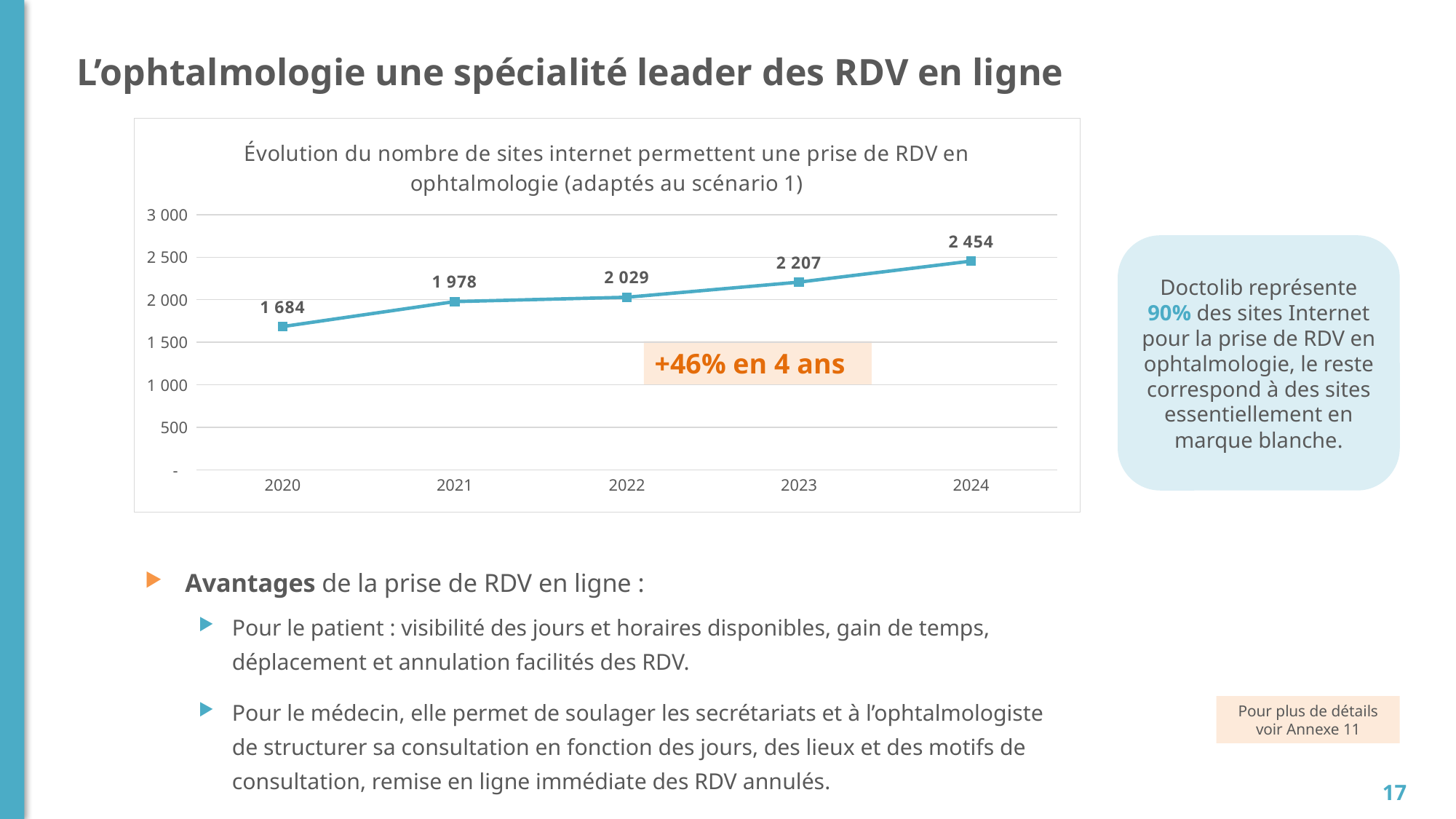
What kind of chart is shown? line chart Which year has the highest value? 2024 What is the value for 2022? 2 029 What is the difference between the values for 2023 and 2022? 178 Which is larger, the value for 2021 or the value for 2023? 2023 What is the difference between the values for 2024 and 2020? 770 How many years are plotted on the chart? 5 Do the values rise or fall from 2020 to 2024? rise What is the value for 2024? 2 454 What is the value for 2020? 1 684 Which year has the lowest value? 2020 Is the value for 2021 greater or less than 1 500? greater